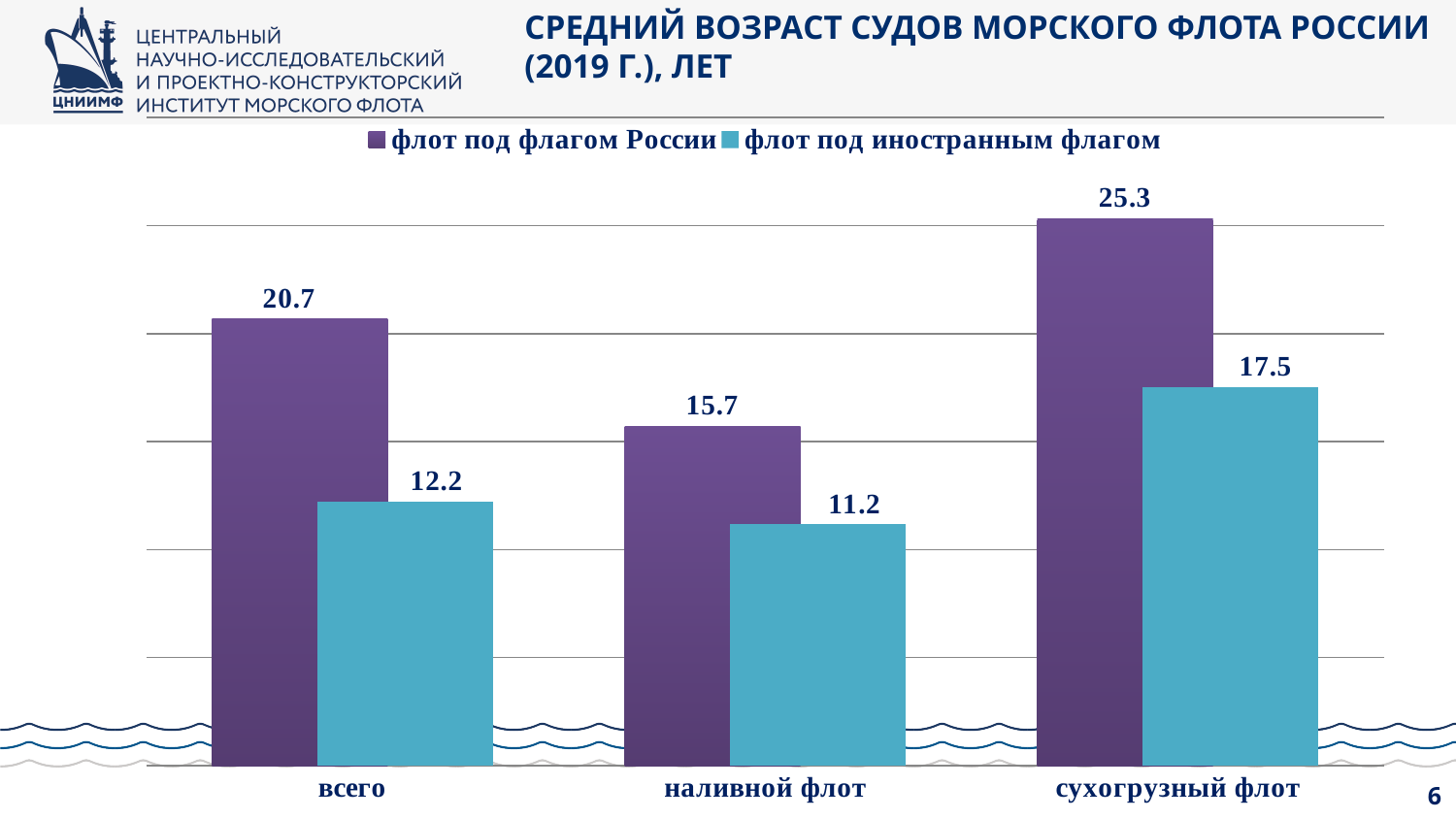
What is the difference between 'флот под флагом России' and 'флот под иностранным флагом' in the 'всего' category? 8.5 What is the value for 'флот под флагом России' in the 'всего' category? 20.7 What is the value for 'флот под иностранным флагом' in the 'сухогрузный флот' category? 17.5 In the 'наливной флот' category, which series has the larger value: 'флот под флагом России' or 'флот под иностранным флагом'? флот под флагом России How many categories are shown on the x axis? 3 What is the value for 'флот под флагом России' in the 'сухогрузный флот' category? 25.3 Which category has the highest value for 'флот под флагом России'? сухогрузный флот What is the value for 'флот под иностранным флагом' in the 'наливной флот' category? 11.2 What kind of chart is shown on the slide? bar chart Which category has the lowest value for 'флот под иностранным флагом'? наливной флот How many series does the legend list? 2 What is the title of the chart? СРЕДНИЙ ВОЗРАСТ СУДОВ МОРСКОГО ФЛОТА РОССИИ (2019 Г.), ЛЕТ